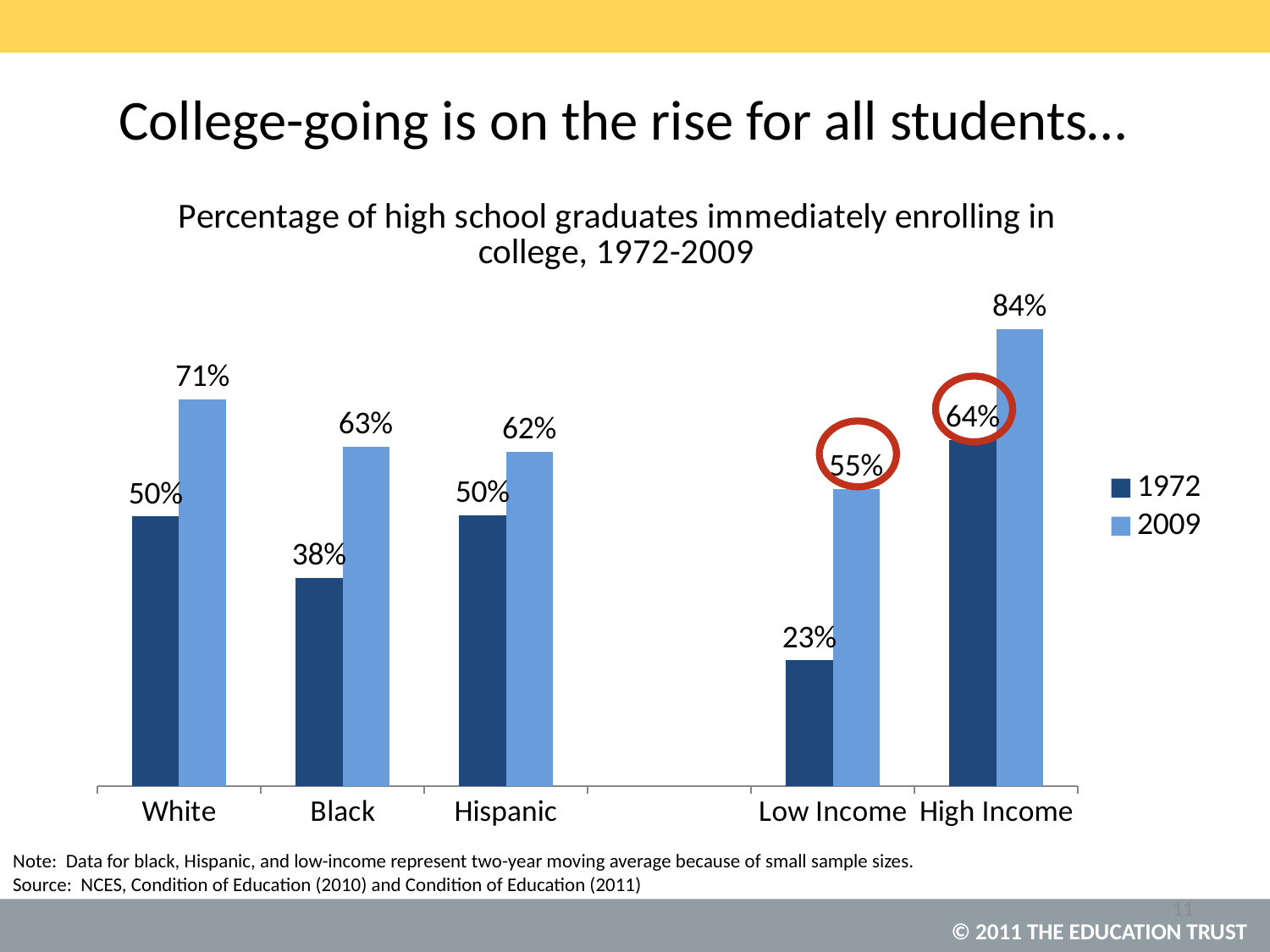
What is the difference between the High Income and Low Income percentages in 2009? 29 percentage points What was the percentage for Low Income students in 1972? 23% Which was larger in 2009: the percentage for Black students or for Hispanic students? Black How many categories are shown on the x axis? 5 What was the percentage for Black students in 1972? 38% Which two years are listed in the legend? 1972 and 2009 What is the difference between the 2009 and 1972 percentages for Low Income students? 32 percentage points What was the percentage of White high school graduates immediately enrolling in college in 2009? 71% How many series does the legend list? 2 Which category had the highest percentage in 2009? High Income What kind of chart is shown on the slide? Bar chart Which category had the lowest percentage in 1972? Low Income